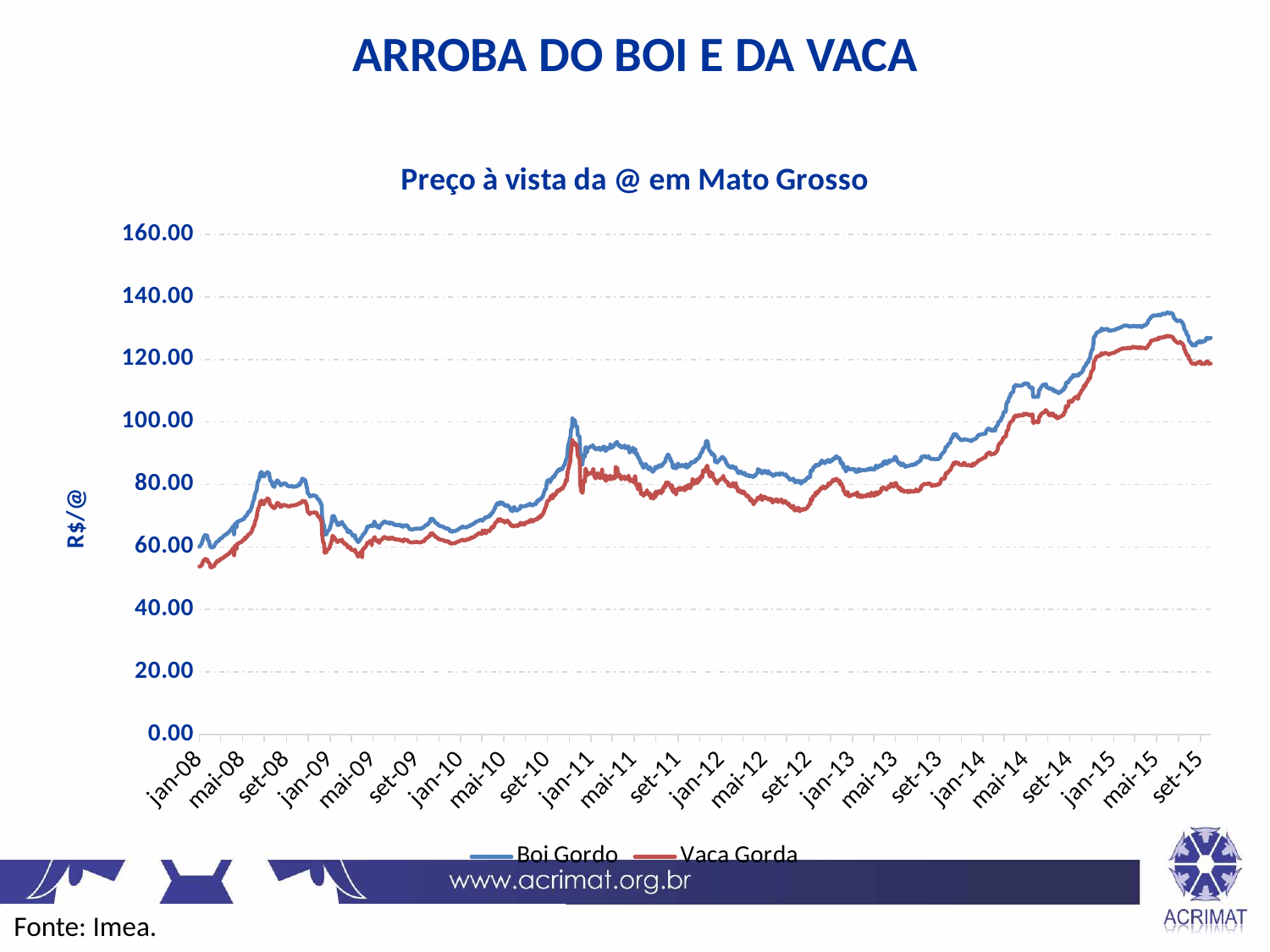
What are the two series named in the legend? Boi Gordo and Vaca Gorda How many series does the legend list? 2 What is the title of the chart? Preço à vista da @ em Mato Grosso Is the Vaca Gorda value at set-12 greater or less than 80.00? less What kind of chart is shown on the slide? line chart Is the Boi Gordo value at mai-15 greater or less than 120.00? greater How many date labels are shown on the x axis? 24 Overall, do the Boi Gordo values rise or fall from jan-08 to set-15? rise Is the Vaca Gorda value at jan-08 greater or less than 60.00? less Which series is higher throughout the chart, Boi Gordo or Vaca Gorda? Boi Gordo